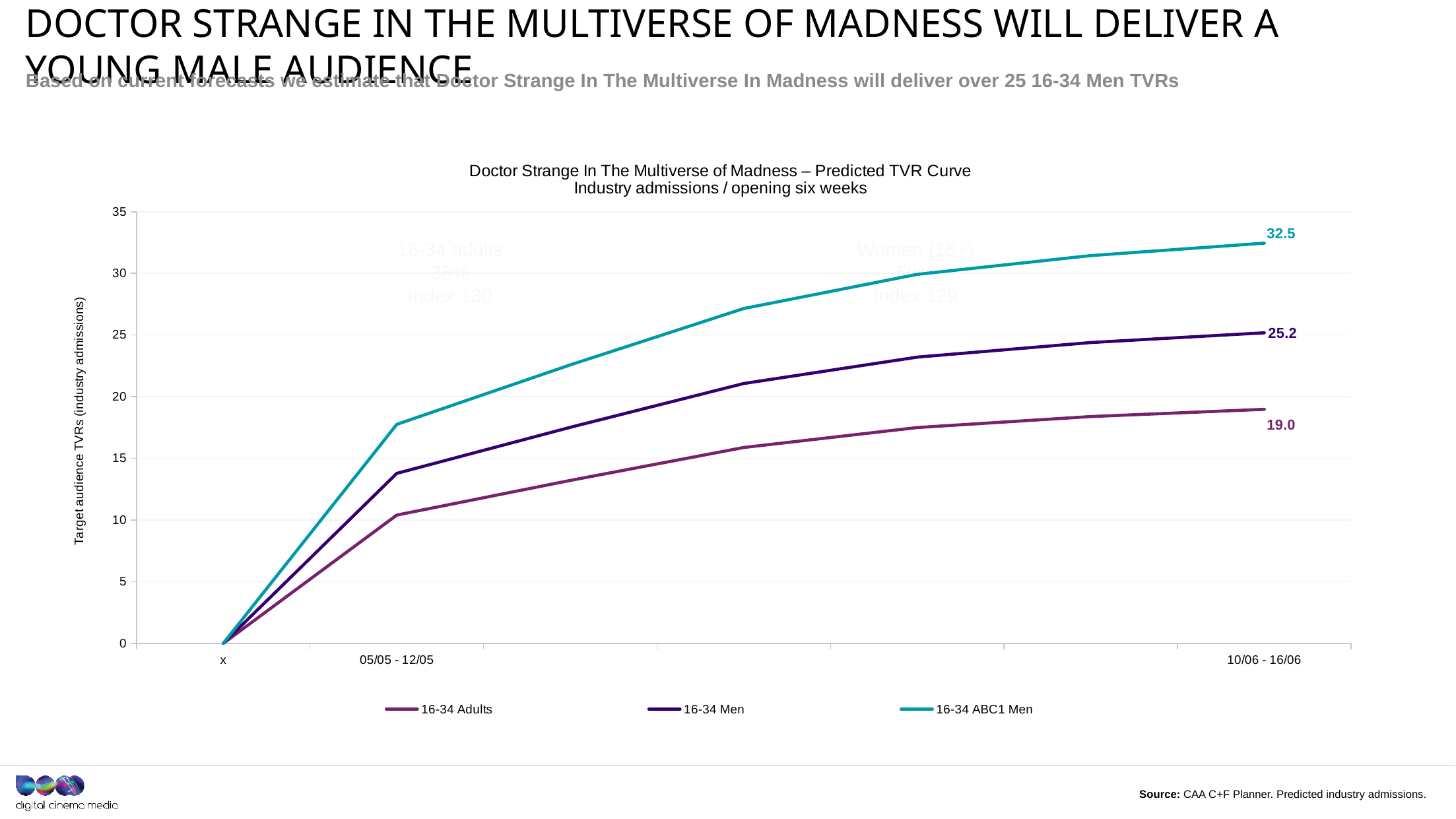
How many series does the legend list? 3 Is the value for 16-34 Adults at 05/05 - 12/05 greater or less than 15? less Which series has the lowest value at 10/06 - 16/06? 16-34 Adults What is the difference between the final values for 16-34 Men and 16-34 Adults? 6.2 What is the final value for 16-34 Adults at 10/06 - 16/06? 19.0 Do the values for 16-34 Men rise or fall along the x axis? rise What is the label of the y axis? Target audience TVRs (industry admissions) What is the final value for 16-34 ABC1 Men at 10/06 - 16/06? 32.5 What is the final value for 16-34 Men at 10/06 - 16/06? 25.2 What is the difference between the final values for 16-34 ABC1 Men and 16-34 Men? 7.3 What kind of chart is shown on the slide? line chart Which series has the highest value at 10/06 - 16/06? 16-34 ABC1 Men